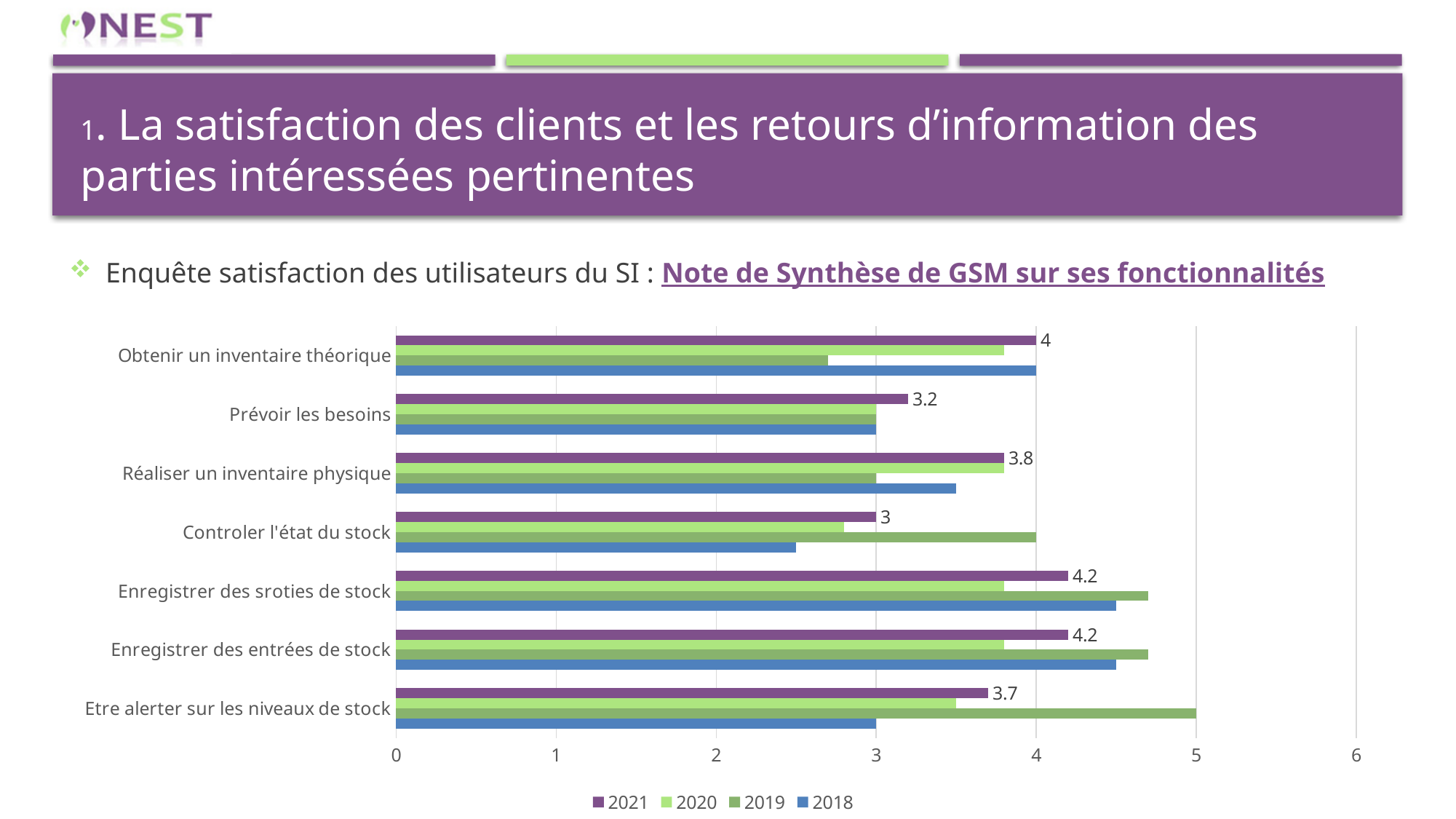
What is the 2021 value for "Prévoir les besoins"? 3.2 What is the 2021 value for "Obtenir un inventaire théorique"? 4 What is the 2021 value for "Etre alerter sur les niveaux de stock"? 3.7 What is the difference between the 2021 values for "Réaliser un inventaire physique" and "Controler l'état du stock"? 0.8 How many categories are shown on the chart? 7 Is the 2019 value for "Etre alerter sur les niveaux de stock" greater or less than 4? greater Which category has the lowest 2021 value? Controler l'état du stock Is the 2018 value for "Controler l'état du stock" greater or less than 3? less What kind of chart is shown on the slide? bar chart For 2021, which is larger: "Réaliser un inventaire physique" or "Prévoir les besoins"? Réaliser un inventaire physique Which series is shown in purple? 2021 How many series does the legend list? 4